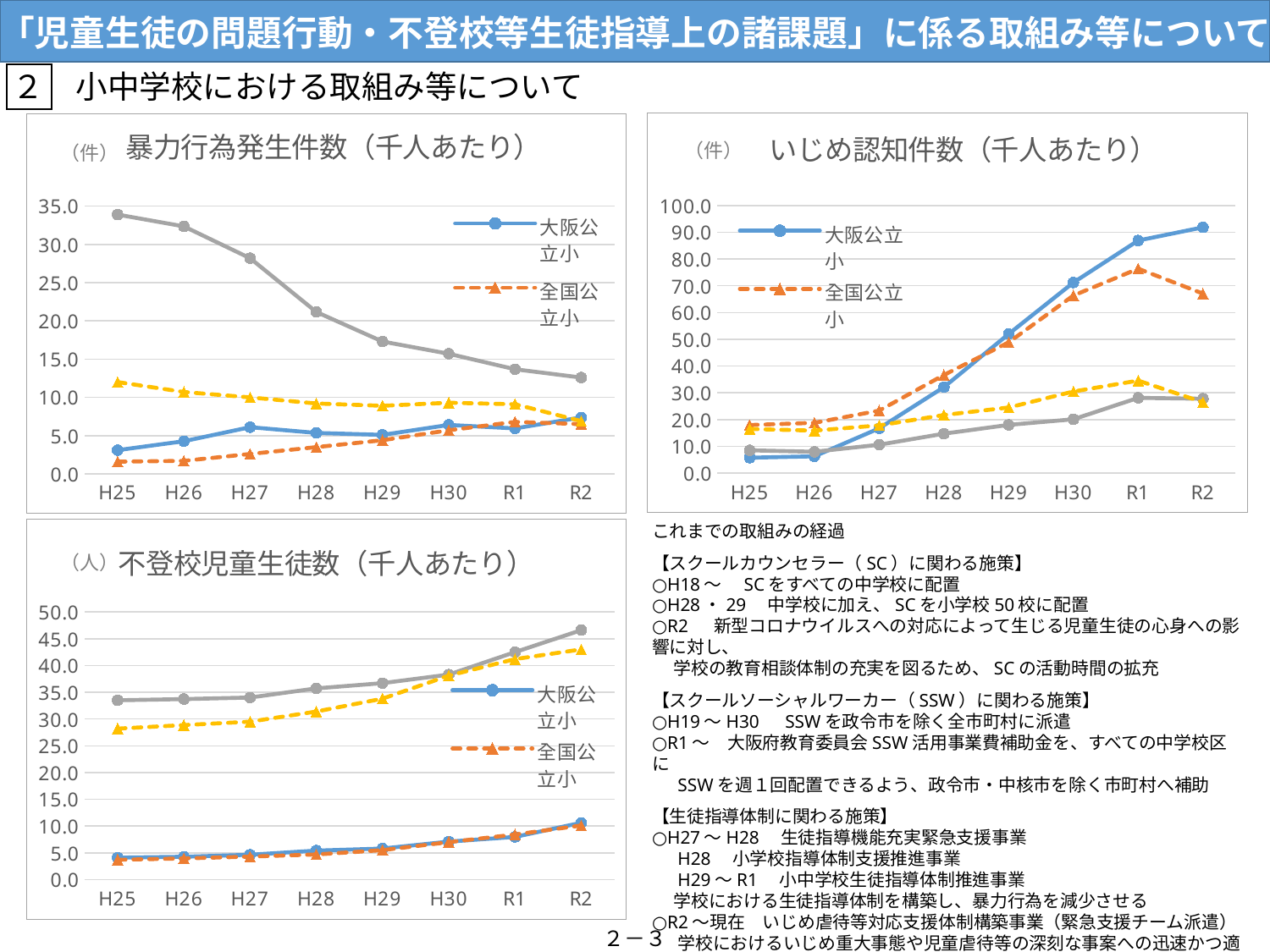
In the 不登校児童生徒数（千人あたり） chart, how many series does the legend list? 2 What kind of chart is the 暴力行為発生件数（千人あたり） chart? line chart In the 不登校児童生徒数（千人あたり） chart, is the value for 全国公立小 at H25 greater or less than 5.0? less What is the title of the chart in the top-left of the slide? 暴力行為発生件数（千人あたり） In the いじめ認知件数（千人あたり） chart, which series is higher at R2, 大阪公立小 or 全国公立小? 大阪公立小 In the 暴力行為発生件数（千人あたり） chart, is the value for 大阪公立小 at H25 greater or less than 5.0? less In the いじめ認知件数（千人あたり） chart, does the 大阪公立小 series rise or fall from H25 to R2? rise In the いじめ認知件数（千人あたり） chart, which series is higher at H25, 大阪公立小 or 全国公立小? 全国公立小 In the いじめ認知件数（千人あたり） chart, how many points are on the x axis? 8 In the いじめ認知件数（千人あたり） chart, at which year is the 大阪公立小 series highest? R2 In the いじめ認知件数（千人あたり） chart, is the value for 大阪公立小 at R2 greater or less than 80.0? greater